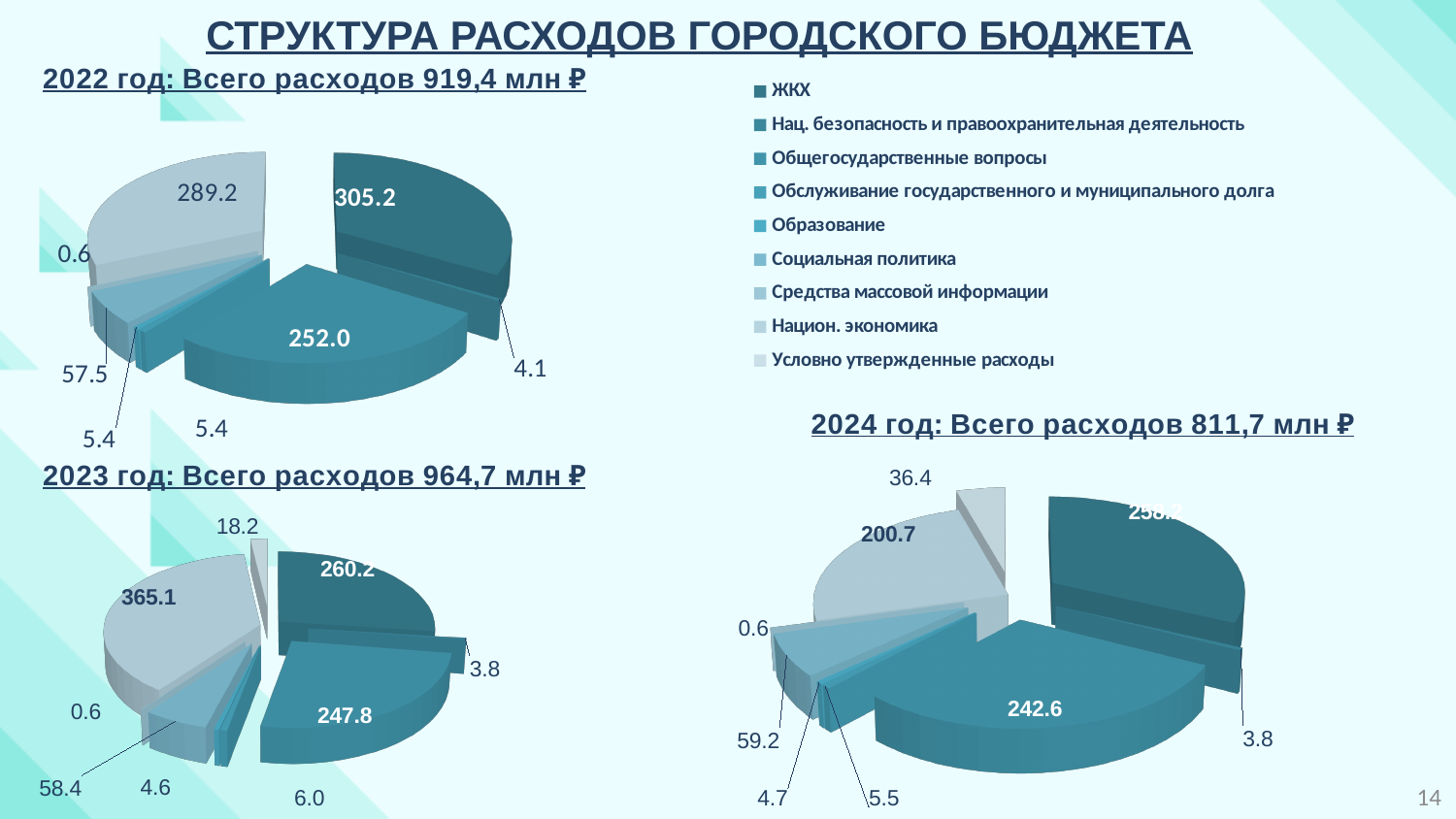
In the 2024 pie chart, what is the value of the smallest slice? 0.6 In the 2023 pie chart, which slice is larger: the one labelled 260.2 or the one labelled 247.8? 260.2 In the 2022 pie chart, what is the value of the largest slice? 305.2 Which year's chart title shows the highest total expenditure: 2022, 2023 or 2024? 2023 How many slices does the 2022 pie chart have? 8 How many slices does the 2023 pie chart have? 9 How many categories does the legend list? 9 In the 2023 pie chart, what is the difference between the slices labelled 365.1 and 260.2? 104.9 What kind of chart is used for the 2022 year ("2022 год: Всего расходов 919,4 млн ₽")? Pie chart In the 2023 pie chart, what is the value of the largest slice? 365.1 According to the chart title, what is the total expenditure for 2024? 811,7 млн ₽ In the 2022 pie chart, what is the difference between the largest slice (305.2) and the second largest slice (289.2)? 16.0